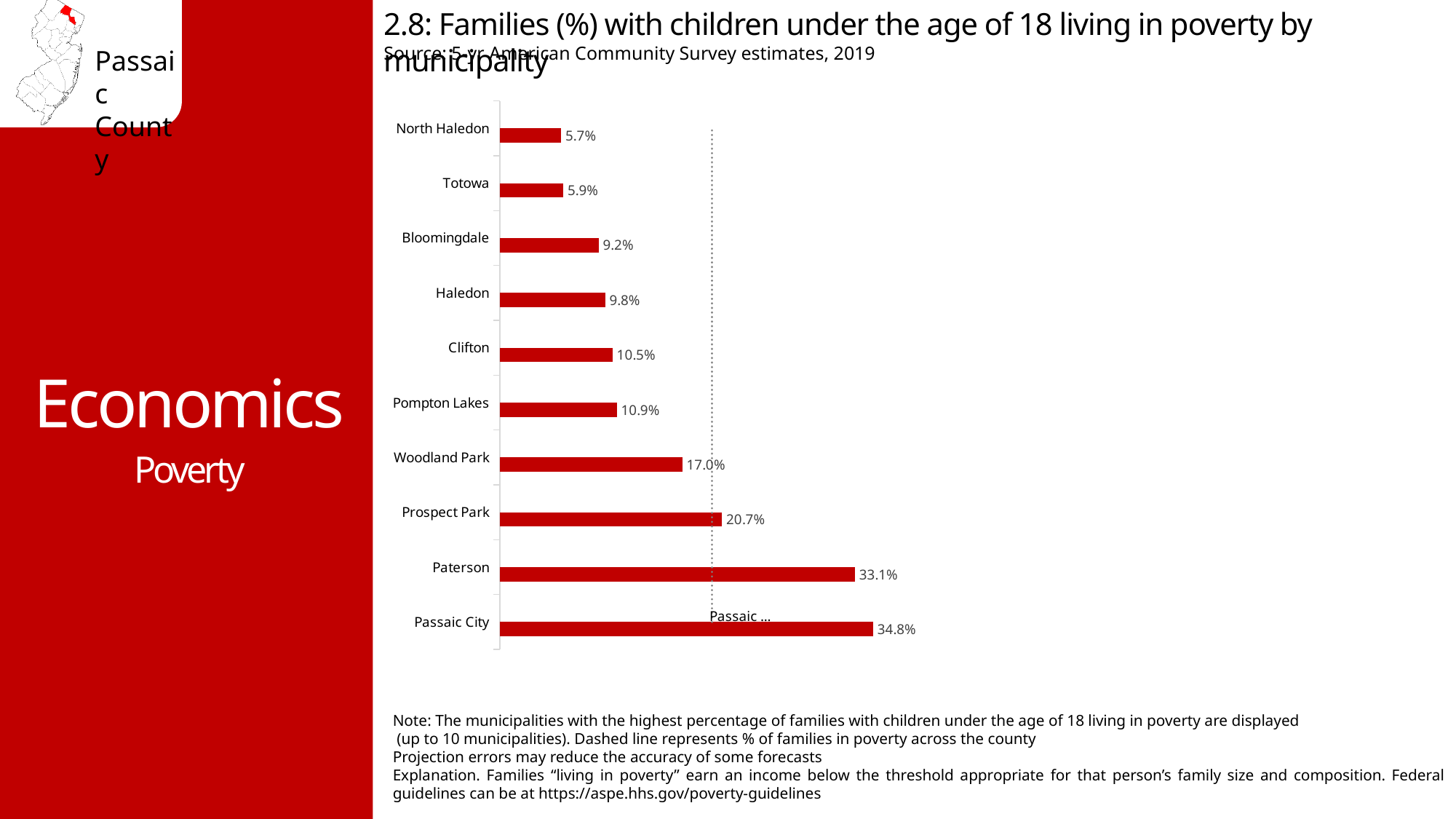
What kind of chart is shown on the slide? Bar chart Which municipality has the lowest percentage shown on the chart? North Haledon Which municipality has the highest percentage of families with children under 18 living in poverty? Passaic City Which has a higher value, Totowa or Pompton Lakes? Pompton Lakes What is the difference between the values for Passaic City and Paterson? 1.7% What is the percentage of families with children under 18 living in poverty in Paterson? 33.1% Which has a higher value, Bloomingdale or Haledon? Haledon What is the difference between the values for Prospect Park and Pompton Lakes? 9.8% What is the value shown for Clifton? 10.5% What is the value shown for Woodland Park? 17.0% What does the dashed vertical line on the chart represent? % of families in poverty across the county How many municipalities are shown on the chart? 10